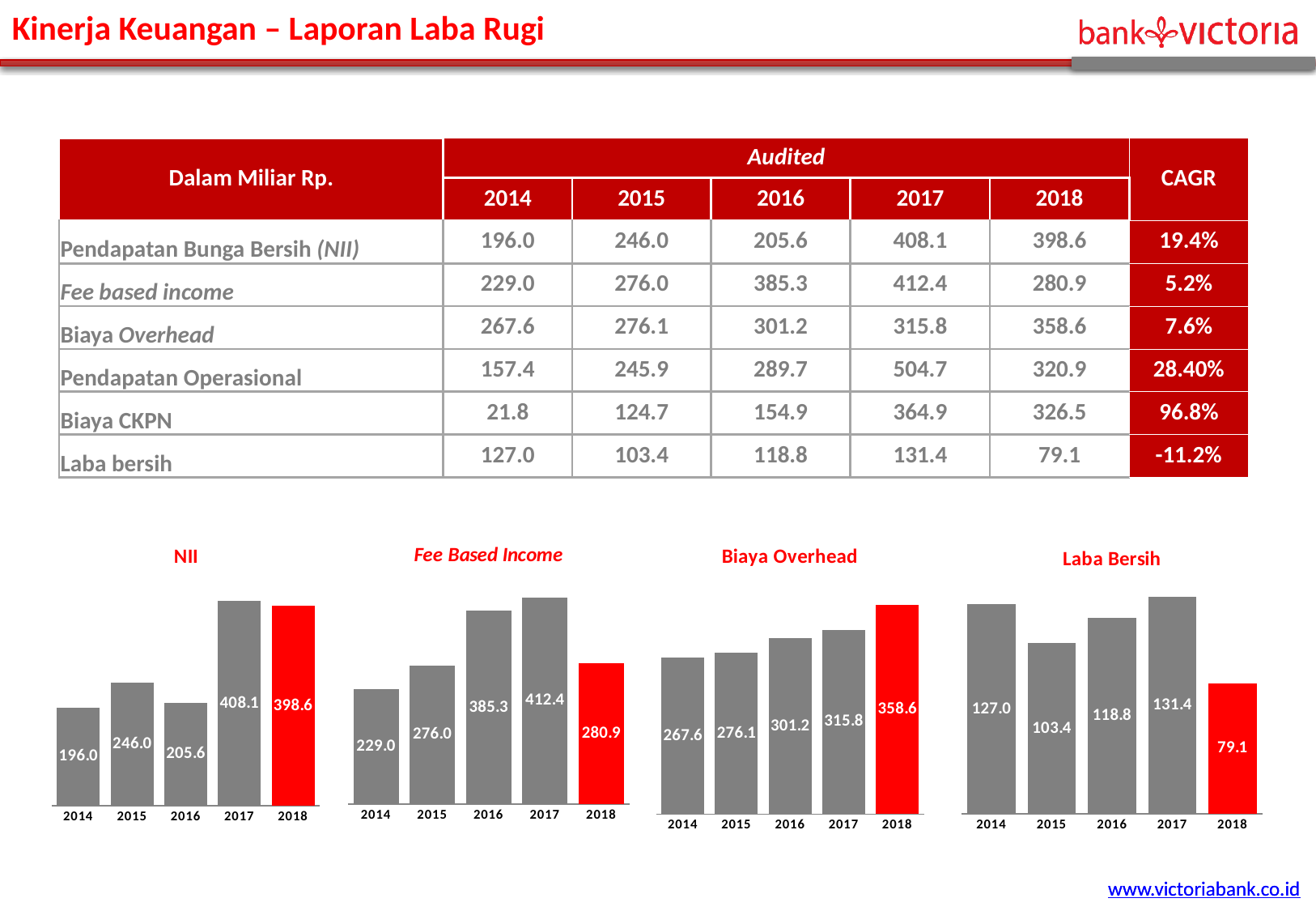
What is the title of the chart on the far left of the slide? NII How many bars are in the Laba Bersih chart? 5 In the Biaya Overhead chart, what is the difference between the 2018 and 2014 values? 91.0 In the Fee Based Income chart, which bar is coloured red? 2018 In the Fee Based Income chart, which year has the highest value? 2017 In the NII chart, is the value for 2015 larger than the value for 2016? Yes, 2015 (246.0) is larger than 2016 (205.6) In the NII chart, what is the value for 2017? 408.1 In the Fee Based Income chart, what is the value for 2018? 280.9 What type of chart is the Biaya Overhead chart? Bar chart In the Laba Bersih chart, which year has the lowest value? 2018 In the Laba Bersih chart, what is the difference between the 2017 and 2018 values? 52.3 In the Biaya Overhead chart, do the values rise or fall from 2014 to 2018? Rise